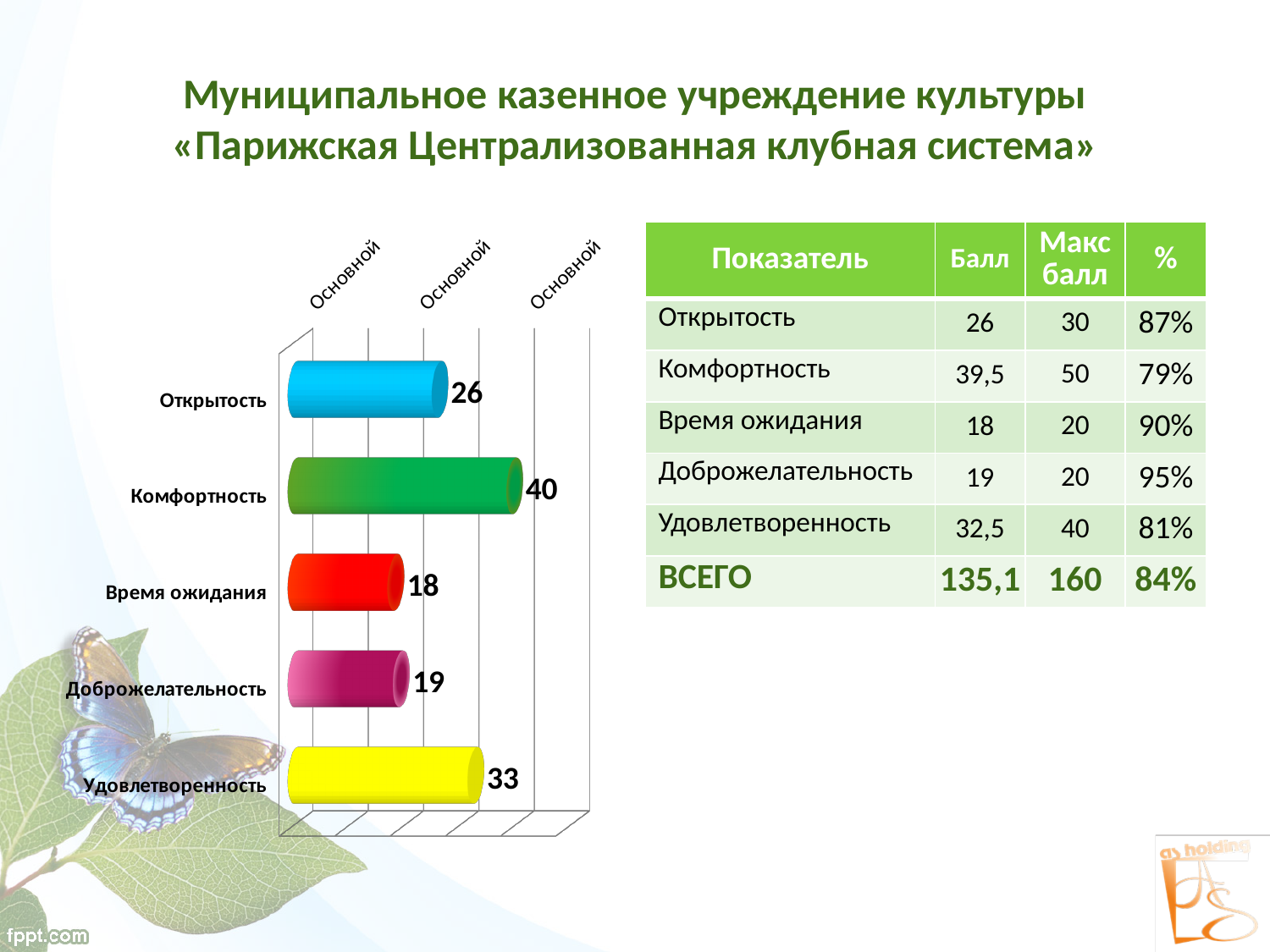
What value is shown for Комфортность in the chart? 40 What colour is the bar for Удовлетворенность in the chart? Yellow What value is shown for Время ожидания in the chart? 18 Which is larger in the chart, the value for Удовлетворенность or the value for Открытость? Удовлетворенность What value is shown for Удовлетворенность in the chart? 33 How many categories are plotted in the chart? 5 Which category has the highest value in the chart? Комфортность Which category has the lowest value in the chart? Время ожидания What is the difference between the values for Комфортность and Открытость in the chart? 14 What value is shown for Открытость in the chart? 26 What kind of chart is shown on the slide? Bar chart What value is shown for Доброжелательность in the chart? 19